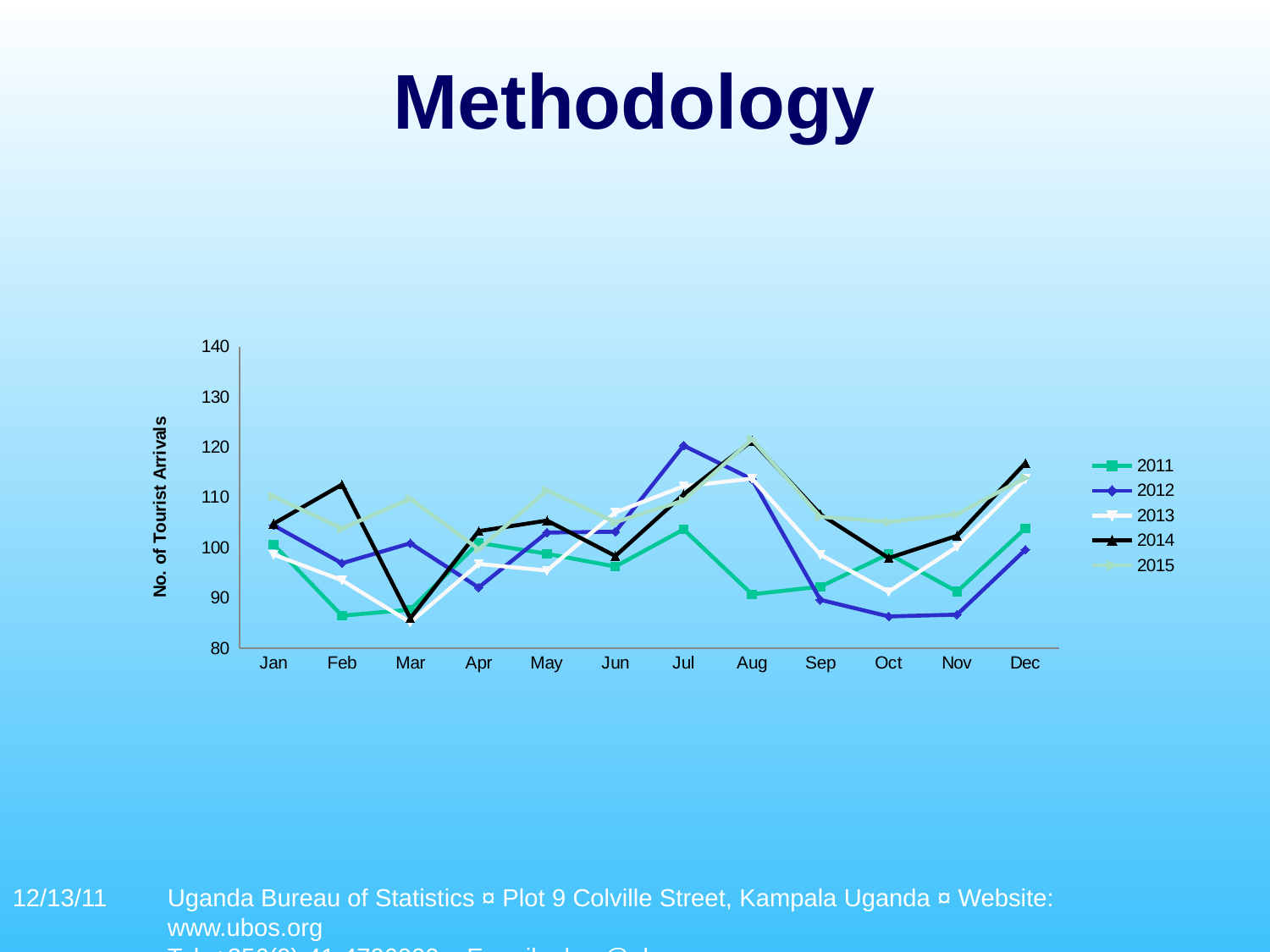
How many months are shown along the x axis? 12 Does the 2012 series rise or fall from Aug to Oct? fall In which month does the 2014 series reach its lowest value? Mar Is the value for 2011 in Feb greater or less than 90? less In which month does the 2015 series reach its highest value? Aug How many series does the legend list? 5 Is the value for 2013 in Mar greater or less than 90? less What kind of chart is shown on the slide? line chart Is the value for 2014 in Aug greater or less than 110? greater In which month does the 2012 series reach its highest value? Jul In Jan, which series has the larger value, 2011 or 2015? 2015